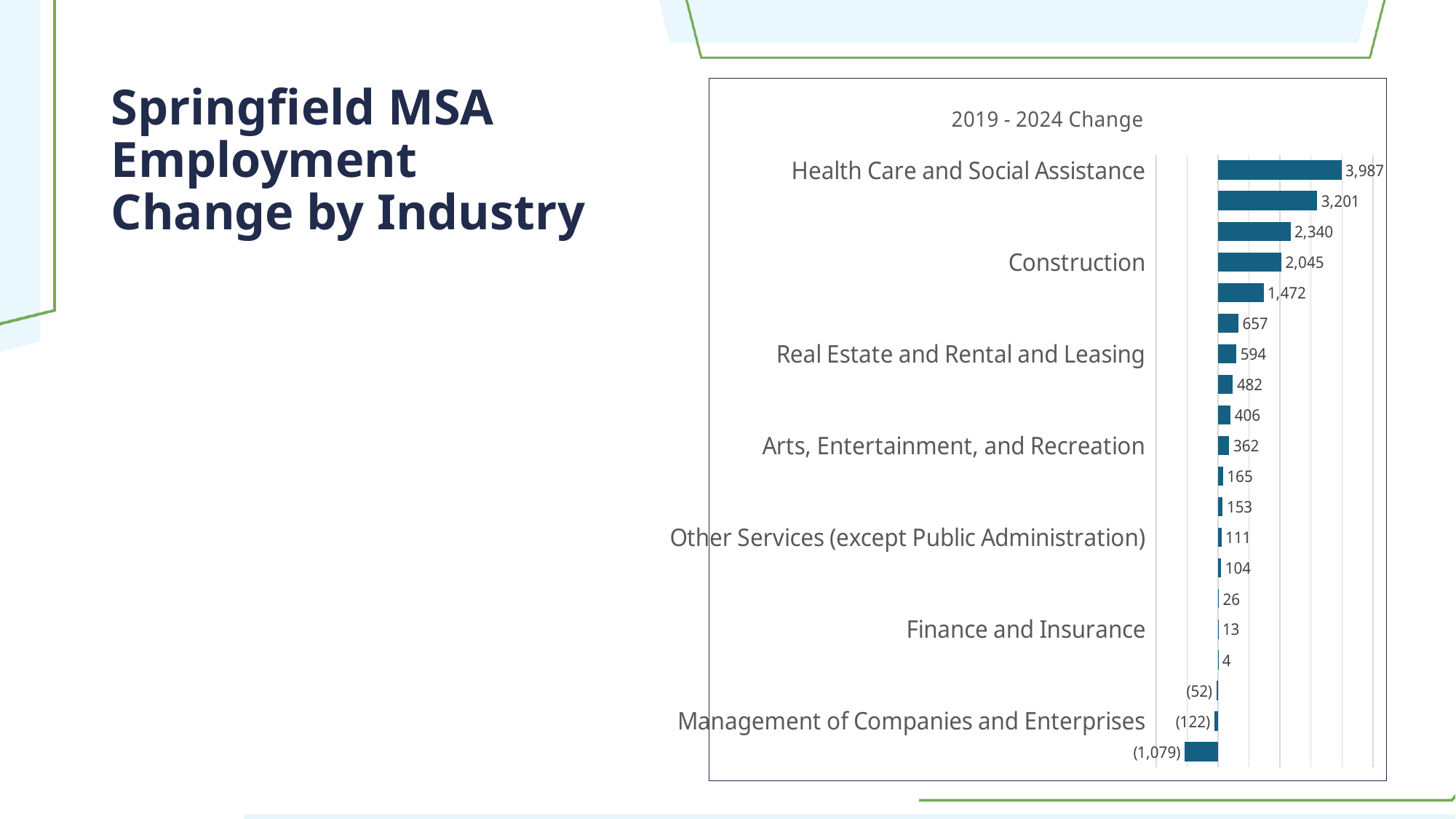
What is the 2019 - 2024 change for Real Estate and Rental and Leasing? 594 What is the title of the chart? 2019 - 2024 Change Which industry has the largest 2019 - 2024 change? Health Care and Social Assistance What is the 2019 - 2024 change for Health Care and Social Assistance? 3,987 What is the 2019 - 2024 change for Management of Companies and Enterprises? (122) What kind of chart is shown on the slide? Bar chart What is the difference between the values for Health Care and Social Assistance and Construction? 1,942 What is the lowest value shown on the chart? (1,079) Which is larger, the value for Real Estate and Rental and Leasing or the value for Arts, Entertainment, and Recreation? Real Estate and Rental and Leasing What is the 2019 - 2024 change for Construction? 2,045 How many bars are plotted on the chart? 20 What is the 2019 - 2024 change for Arts, Entertainment, and Recreation? 362